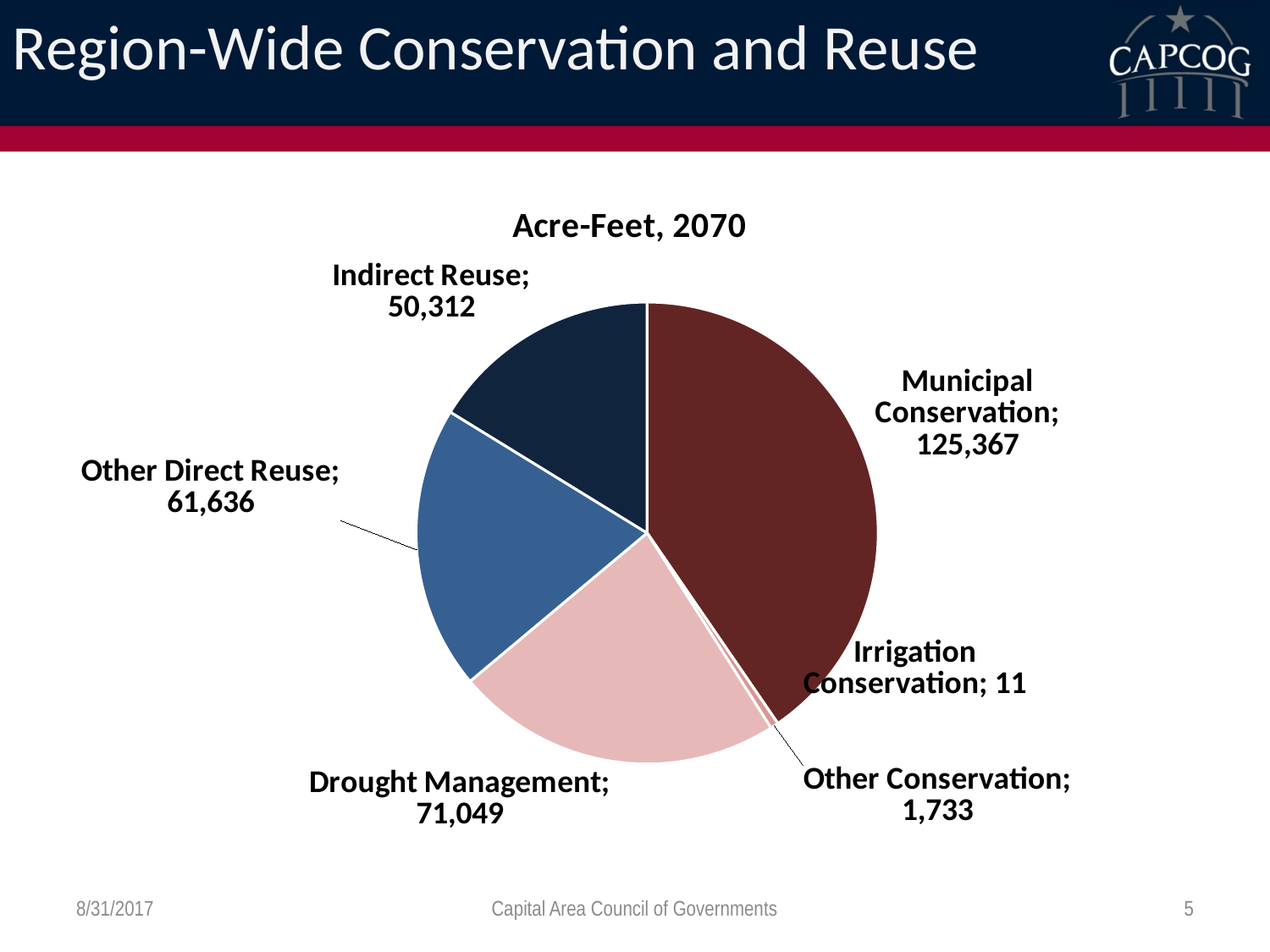
Which category has the smallest slice of the pie? Irrigation Conservation What is the value for Municipal Conservation? 125,367 Which is larger, Drought Management or Other Direct Reuse? Drought Management What is the title of the chart? Acre-Feet, 2070 What is the value for Drought Management? 71,049 What is the difference between Municipal Conservation and Drought Management? 54,318 What is the value for Indirect Reuse? 50,312 How many categories are shown in the pie chart? 6 What is the value for Irrigation Conservation? 11 Which category has the largest slice of the pie? Municipal Conservation What is the difference between Other Direct Reuse and Indirect Reuse? 11,324 What kind of chart is shown on the slide? Pie chart